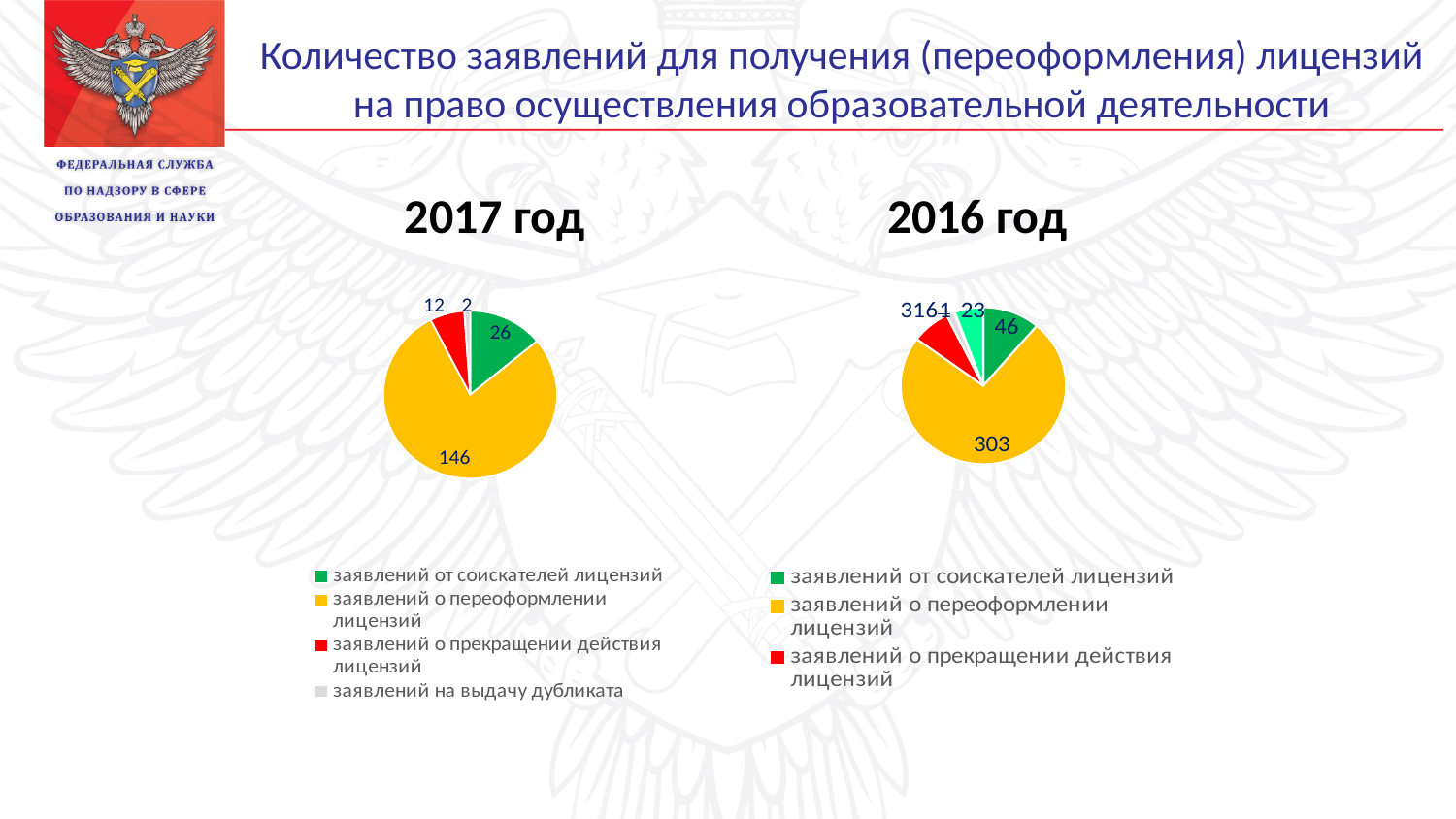
In the 2017 год chart, how many applications were for issuing a duplicate (заявлений на выдачу дубликата)? 2 In the 2017 год chart, how many applications came from licence applicants (заявлений от соискателей лицензий)? 26 In the 2017 год chart, how many applications were for termination of licences (заявлений о прекращении действия лицензий)? 12 How many entries does the legend of the 2017 год chart list? 4 In the 2017 год chart, which category has the largest slice? заявлений о переоформлении лицензий In the 2017 год chart, which category has the smallest slice? заявлений на выдачу дубликата What kind of chart is used for the 2017 год data? pie chart Which is larger: the re-registration applications in 2017 год (146) or the largest slice in 2016 год (303)? 2016 год In the 2017 год chart, what is the total of all slices? 186 In the 2016 год chart, what is the value of the largest slice? 303 In the 2017 год chart, how many applications were for re-registration of licences (заявлений о переоформлении лицензий)? 146 In the 2017 год chart, what is the difference between the re-registration applications and the applications from licence applicants? 120